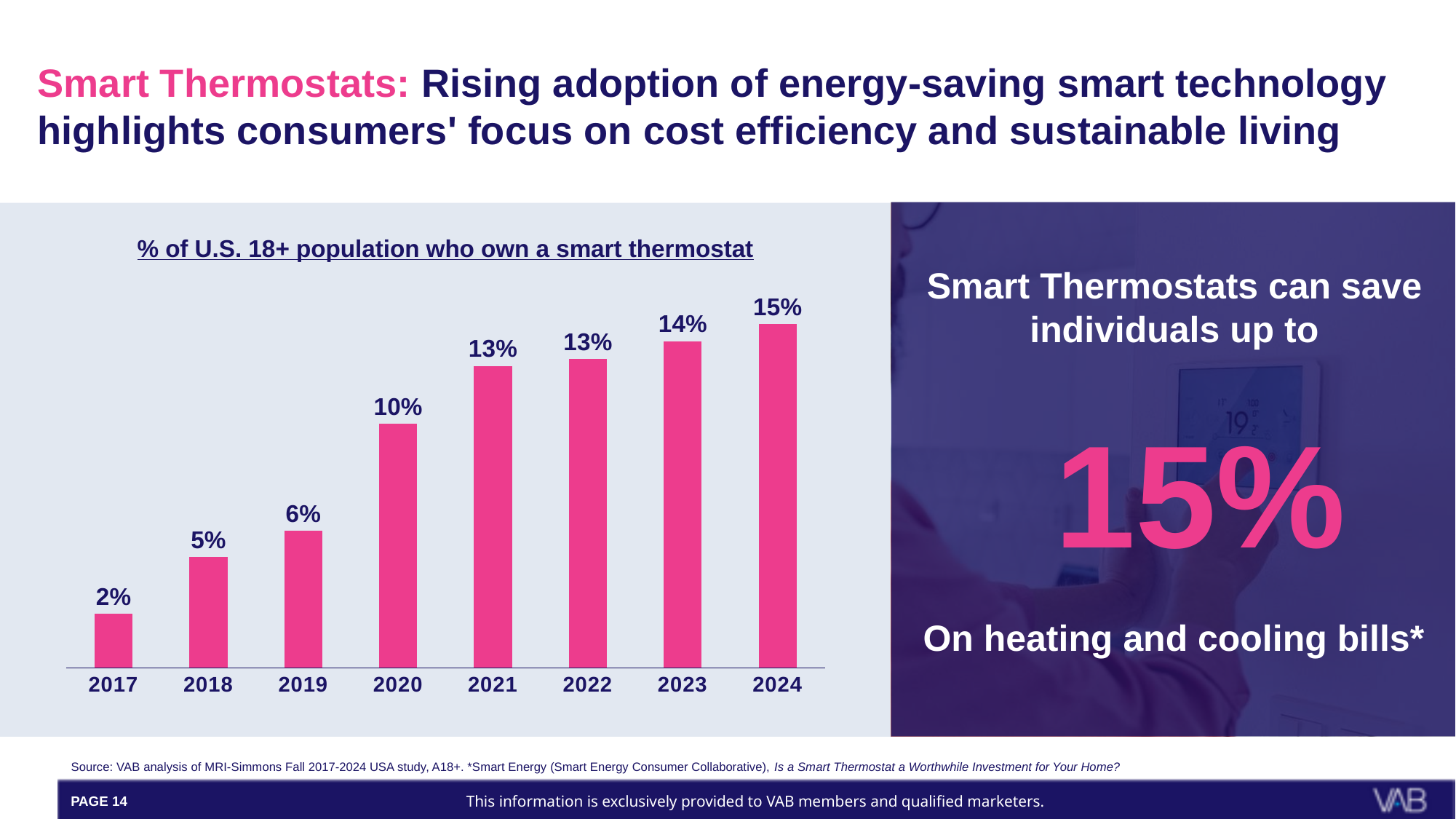
Which year has the lowest share of the U.S. 18+ population owning a smart thermostat? 2017 Which year has a higher value, 2018 or 2019? 2019 Do the values in the chart generally rise or fall from 2017 to 2024? Rise What percentage of the U.S. 18+ population owned a smart thermostat in 2020? 10% What is the value shown for 2017 in the smart thermostat ownership chart? 2% What percentage of the U.S. 18+ population owned a smart thermostat in 2023? 14% Which year has the highest share of the U.S. 18+ population owning a smart thermostat? 2024 By how many percentage points did smart thermostat ownership increase from 2017 to 2024? 13 percentage points What type of chart is used to show smart thermostat ownership? Bar chart What is the title of the chart on the slide? % of U.S. 18+ population who own a smart thermostat What is the difference between the 2020 and 2019 values in the chart? 4 percentage points How many years are shown on the x axis of the chart? 8